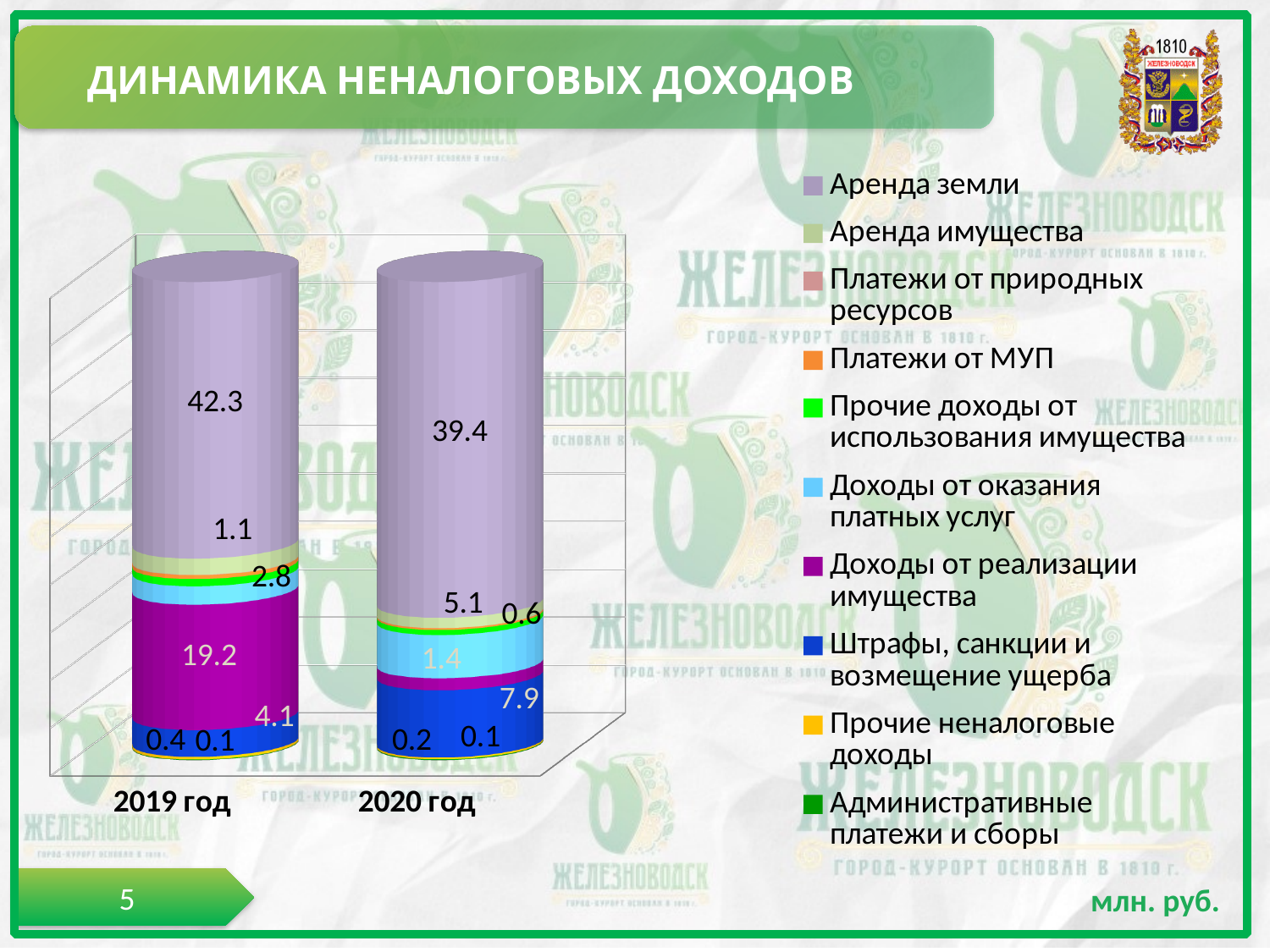
What is the value for Доходы от реализации имущества in 2019 год? 19.2 What is the value for Аренда земли in 2019 год? 42.3 What is the difference between the 2020 год and 2019 год values for Штрафы, санкции и возмещение ущерба? 3.8 What is the value for Аренда земли in 2020 год? 39.4 In what units are the chart values given, according to the slide? млн. руб. What is the value for Штрафы, санкции и возмещение ущерба in 2020 год? 7.9 By how much did Аренда земли decrease from 2019 год to 2020 год? 2.9 How many years (categories) are shown on the x axis of the chart? 2 What kind of chart is shown on the slide? Stacked bar chart Which year has the larger value for Аренда земли, 2019 год or 2020 год? 2019 год How many series does the chart legend list? 10 What is the value for Штрафы, санкции и возмещение ущерба in 2019 год? 4.1